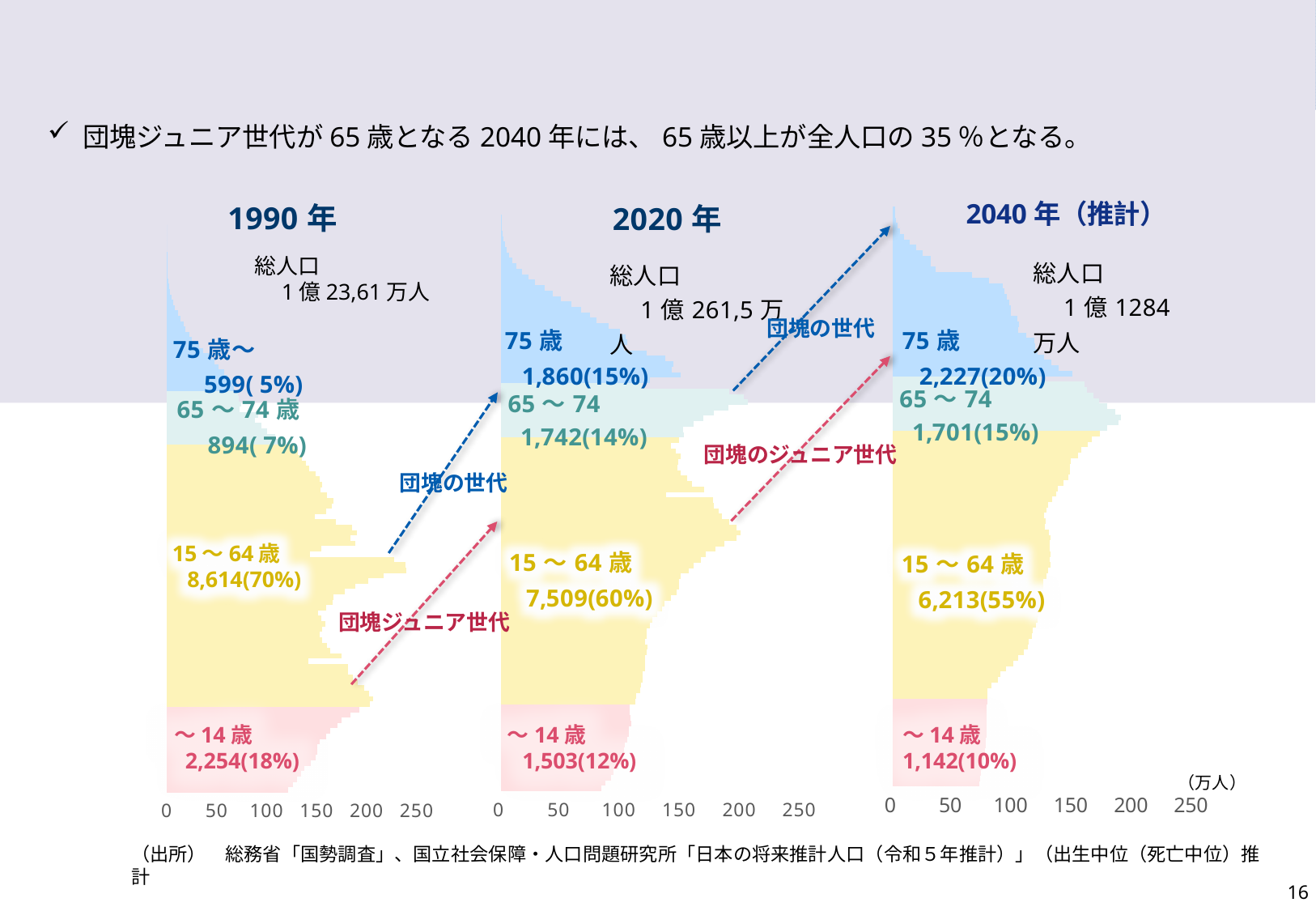
In the 2040年（推計） chart, what is the value shown for the 65〜74 age group? 1,701(15%) Does the share of the 15〜64歳 age group rise or fall from the 1990年 chart to the 2040年（推計） chart? Fall In the 1990年 chart, what is the value shown for the 15〜64歳 age group? 8,614(70%) In the 2040年（推計） chart, what is the value shown for the 〜14歳 age group? 1,142(10%) What is the difference between the 15〜64歳 population in the 1990年 chart (8,614) and in the 2040年（推計） chart (6,213)? 2,401 In the 2020年 chart, what is the value shown for the 75歳 age group? 1,860(15%) Which is larger: the 〜14歳 population in the 2020年 chart or in the 2040年（推計） chart? 2020年 How many age groups are labelled in each population chart? 4 What kind of chart is used to show the population by age on this slide? Bar chart In the 1990年 chart, which age group has the largest population? 15〜64歳 In the 1990年 chart, which age group has the smallest population? 75歳〜 What is the difference between the 75歳 population in the 2040年（推計） chart (2,227) and the 75歳〜 population in the 1990年 chart (599)? 1,628